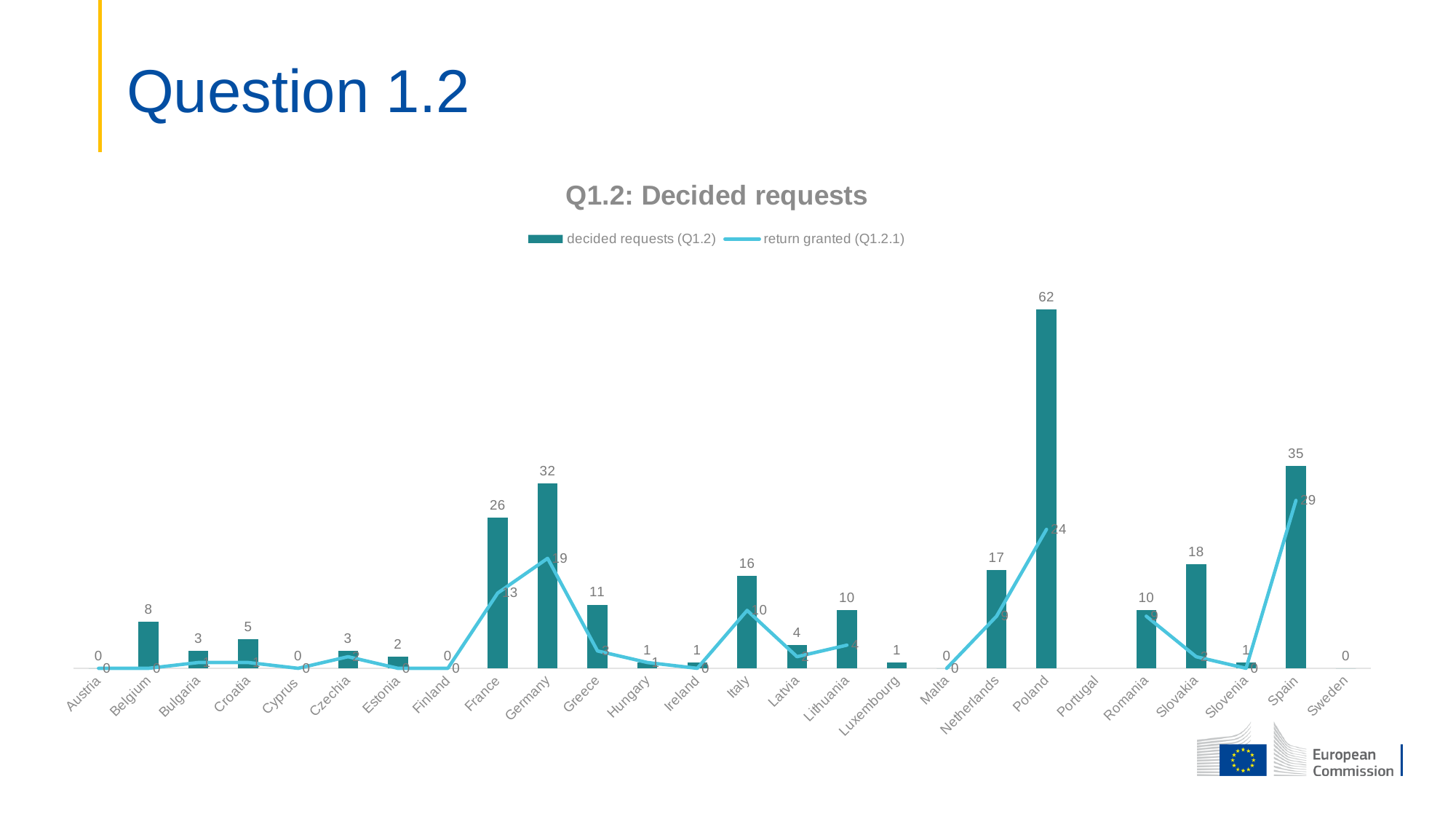
Which has more decided requests (Q1.2), France or Germany? Germany What is the difference in decided requests (Q1.2) between Poland and Spain? 27 How many series does the legend list? 2 What kind of chart is shown on the slide? bar chart with a line How many decided requests (Q1.2) are shown for Poland? 62 What is the title of the chart? Q1.2: Decided requests What is the difference between decided requests (Q1.2) and return granted (Q1.2.1) for Spain? 6 Which country has the highest number of decided requests (Q1.2)? Poland How many decided requests (Q1.2) are shown for Spain? 35 How many decided requests (Q1.2) are shown for Germany? 32 How many countries are shown on the x axis? 26 What is the return granted (Q1.2.1) value for Poland? 24